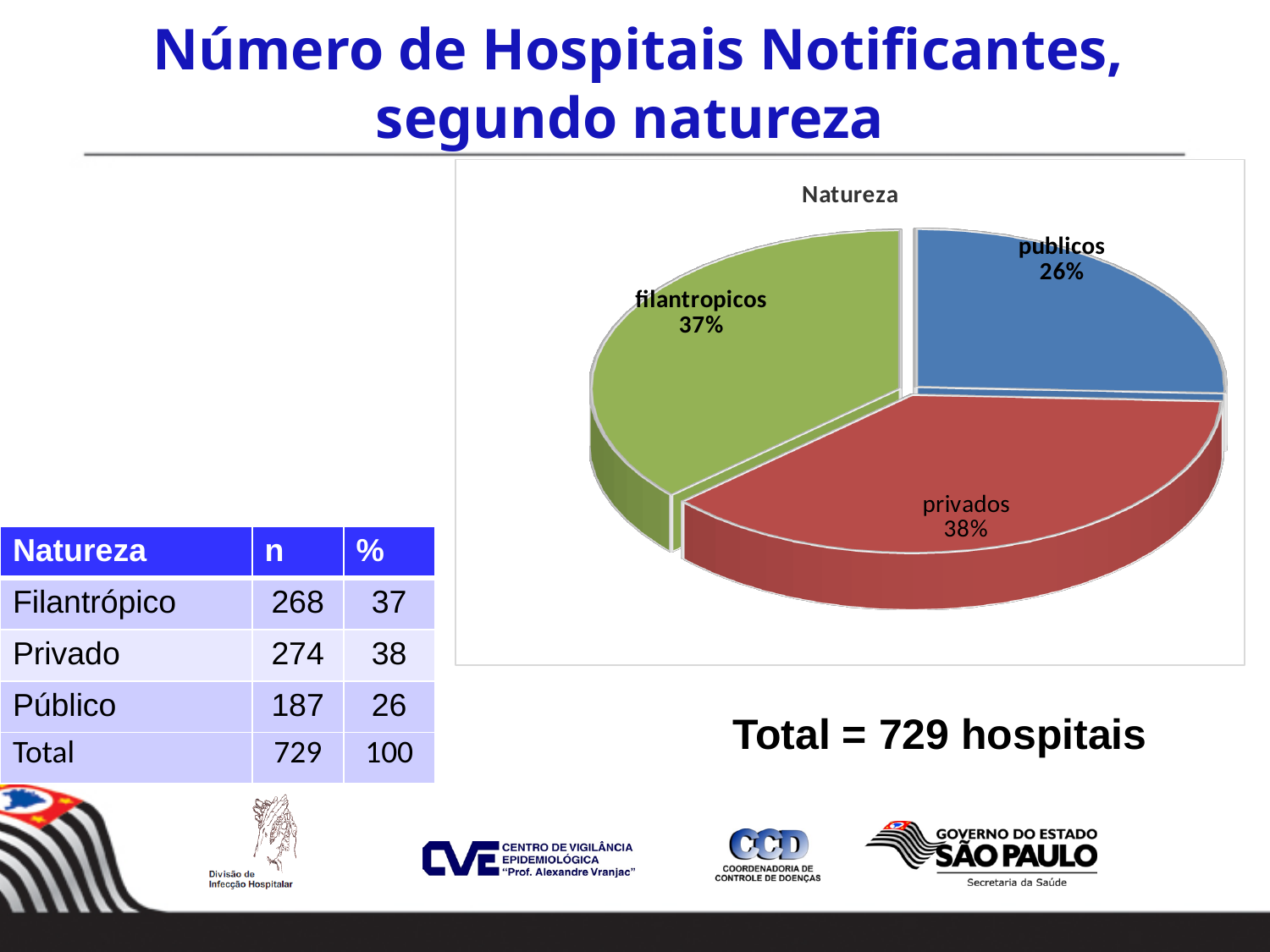
Which slice of the pie chart is the largest? privados What is the difference in percentage points between the 'filantropicos' and 'publicos' slices? 11 What share of the pie does the 'privados' slice represent? 38% How many slices does the pie chart have? 3 What is the difference in percentage points between the 'privados' and 'publicos' slices? 12 What share of the pie does the 'filantropicos' slice represent? 37% What share of the pie does the 'publicos' slice represent? 26% Which is larger in the pie chart, 'filantropicos' or 'publicos'? filantropicos Which slice of the pie chart is the smallest? publicos What colour is the 'privados' slice in the pie chart? red What is the title of the pie chart? Natureza What kind of chart is shown on the slide? pie chart